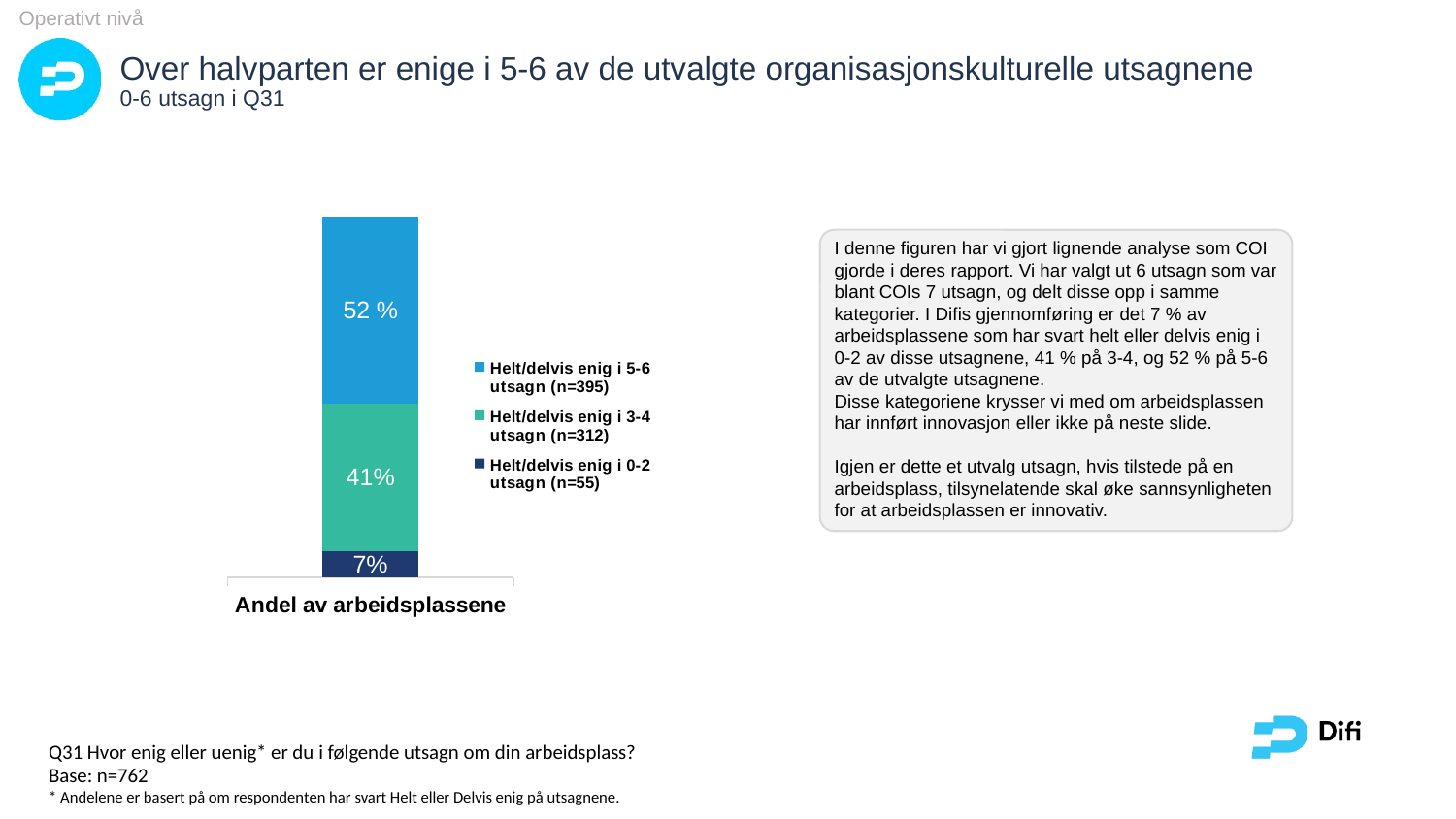
What is the total of the stacked bar? 100% Which segment of the stacked bar is the smallest? Helt/delvis enig i 0-2 utsagn (n=55) What is the difference in percentage points between the 5-6 utsagn segment and the 3-4 utsagn segment? 11 How many series does the legend list? 3 What is the sample size (n) given in the legend for the 3-4 utsagn series? n=312 Which segment of the stacked bar is the largest? Helt/delvis enig i 5-6 utsagn (n=395) What share of workplaces agree fully or partly with 0-2 of the selected statements? 7% Which is larger: the share for 3-4 utsagn or the share for 0-2 utsagn? 3-4 utsagn What share of workplaces agree fully or partly with 3-4 of the selected statements? 41% What share of workplaces agree fully or partly with 5-6 of the selected statements? 52 % What kind of chart is shown on the slide? Stacked bar chart What is the label of the category on the x axis? Andel av arbeidsplassene